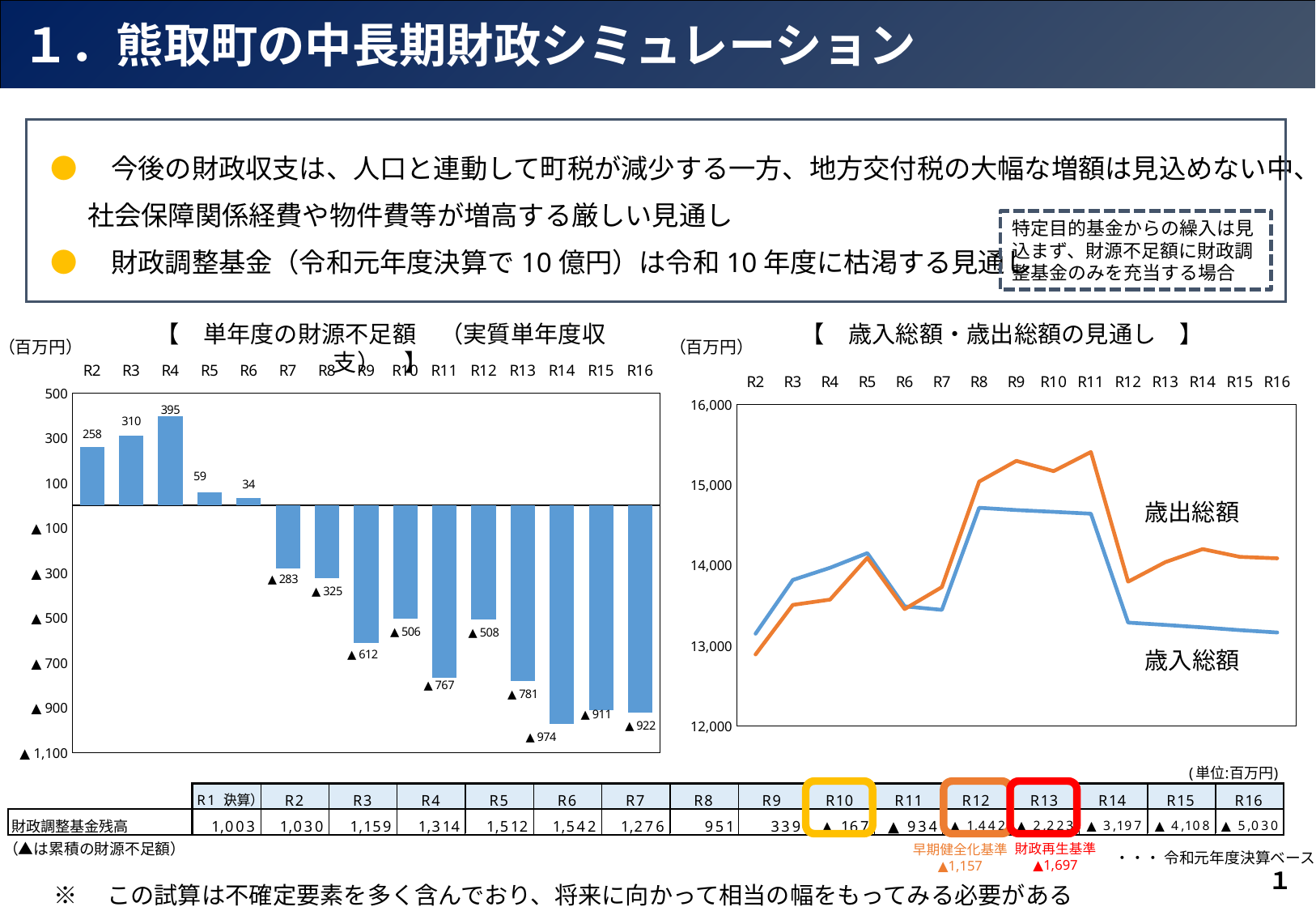
What kind of chart is the right chart 歳入総額・歳出総額の見通し? line chart In the bar chart 単年度の財源不足額（実質単年度収支）, which year has the lowest value? R14 In the bar chart 単年度の財源不足額（実質単年度収支）, what is the value for R14? ▲974 In the bar chart 単年度の財源不足額（実質単年度収支）, which year has the highest value? R4 In the bar chart 単年度の財源不足額（実質単年度収支）, which year has the larger value, R2 or R3? R3 What kind of chart is the left chart 単年度の財源不足額（実質単年度収支）? bar chart In the bar chart 単年度の財源不足額（実質単年度収支）, what is the value for R4? 395 In the right chart 歳入総額・歳出総額の見通し, is the value of 歳出総額 at R9 greater or less than 15,000? greater In the right chart 歳入総額・歳出総額の見通し, does 歳入総額 rise or fall from R11 to R12? fall How many series are plotted in the right chart 歳入総額・歳出総額の見通し? 2 In the bar chart 単年度の財源不足額（実質単年度収支）, what is the difference between the values for R3 and R2? 52 How many years are shown on the x axis of the bar chart 単年度の財源不足額（実質単年度収支）? 15